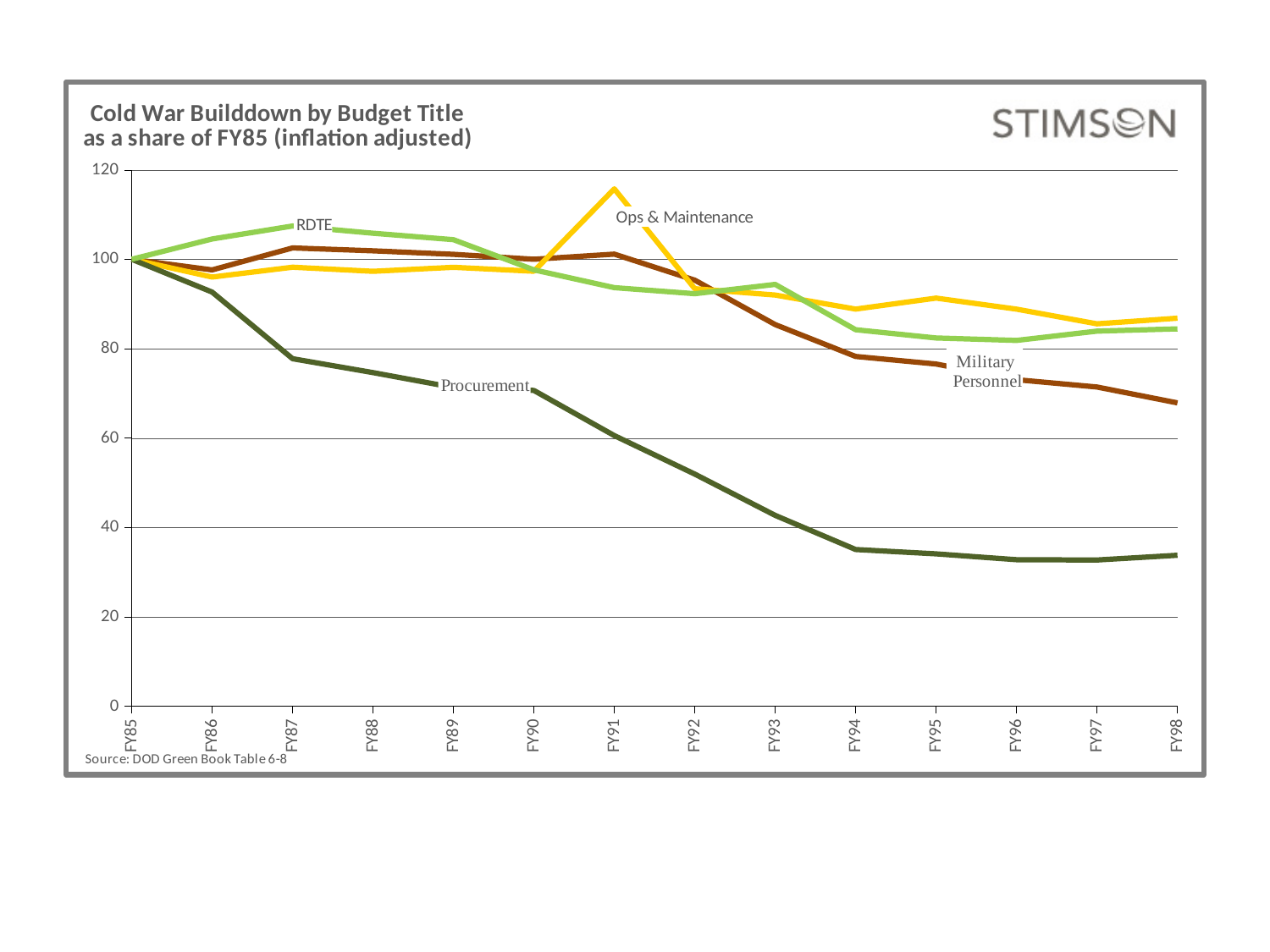
What source is cited for the chart data? DOD Green Book Table 6-8 Is the value for Military Personnel in FY98 greater or less than 60? greater Which series has the lowest value in FY98? Procurement How many budget title series are plotted on the chart? 4 How many fiscal years are plotted along the x axis? 14 What is the value for Procurement in FY85? 100 Is the value for Ops & Maintenance in FY91 greater or less than 100? greater Which series has the highest value in FY91? Ops & Maintenance Does the Procurement line rise or fall from FY85 to FY98? Falls What kind of chart is shown on the slide? Line chart Is the value for Procurement in FY98 greater or less than 40? less In FY94, which is larger, RDTE or Procurement? RDTE